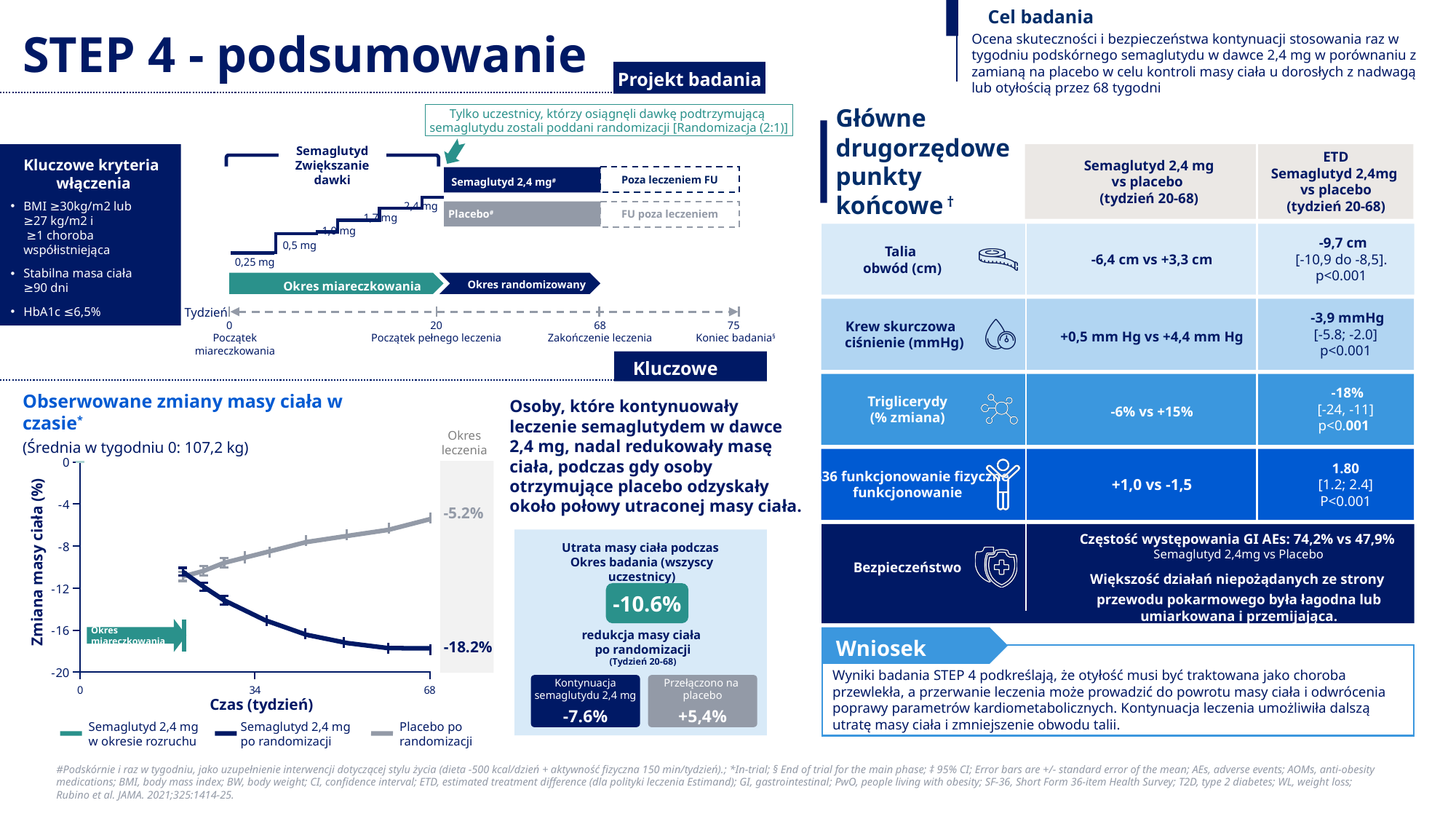
In the 'Obserwowane zmiany masy ciała w czasie' chart, what is the difference between the week-68 values of 'Semaglutyd 2,4 mg po randomizacji' (-18.2%) and 'Placebo po randomizacji' (-5.2%)? 13.0 percentage points In the 'Obserwowane zmiany masy ciała w czasie' chart, which series shows the greater weight loss at week 68: 'Semaglutyd 2,4 mg po randomizacji' or 'Placebo po randomizacji'? Semaglutyd 2,4 mg po randomizacji In the 'Obserwowane zmiany masy ciała w czasie' chart, does the 'Semaglutyd 2,4 mg po randomizacji' line rise or fall between week 20 and week 68? Falls How many series does the legend of the 'Obserwowane zmiany masy ciała w czasie' chart list? 3 According to the subtitle of the 'Obserwowane zmiany masy ciała w czasie' chart, what was the mean body weight at week 0? 107,2 kg In the 'Obserwowane zmiany masy ciała w czasie' chart, does the 'Placebo po randomizacji' line rise or fall between week 20 and week 68? Rises What is the title of the line chart on the slide? Obserwowane zmiany masy ciała w czasie What kind of chart is 'Obserwowane zmiany masy ciała w czasie'? Line chart In the 'Obserwowane zmiany masy ciała w czasie' chart, which series reaches the lowest value at week 68? Semaglutyd 2,4 mg po randomizacji In the 'Obserwowane zmiany masy ciała w czasie' chart, what is the body weight change at week 68 for 'Placebo po randomizacji'? -5.2% In the 'Obserwowane zmiany masy ciała w czasie' chart, what is the body weight change at week 68 for 'Semaglutyd 2,4 mg po randomizacji'? -18.2% In the 'Obserwowane zmiany masy ciała w czasie' chart, is the value for 'Placebo po randomizacji' at week 68 greater or less than -8? greater